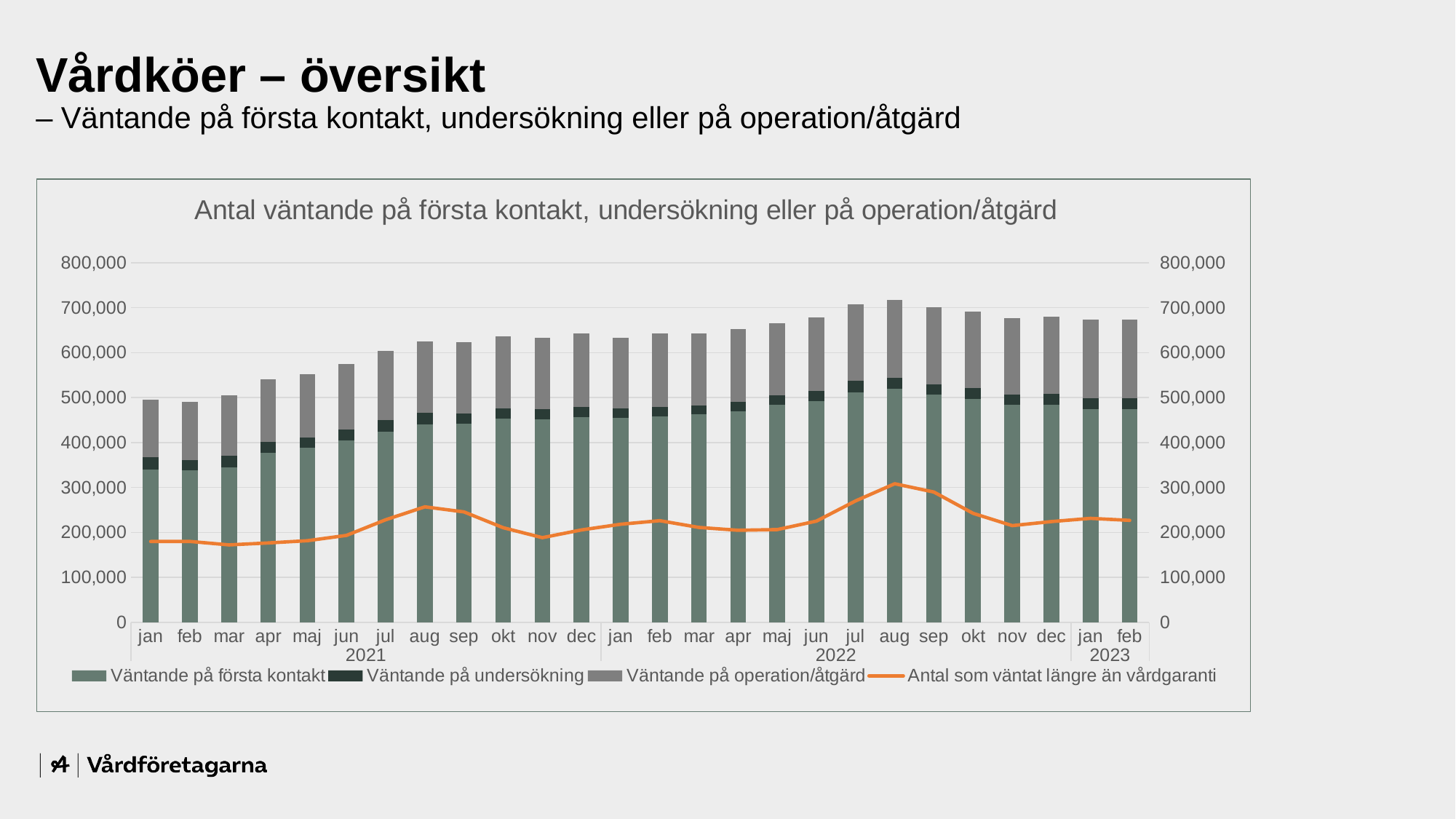
Do the total stacked bars generally rise or fall from jan 2021 to aug 2022? rise Is the value of the line 'Antal som väntat längre än vårdgaranti' for jan 2021 greater or less than 200,000? less Which has the larger total stacked bar, jan 2021 or aug 2022? aug 2022 In which month is the total stacked bar highest? aug 2022 Is the total stacked bar for aug 2021 greater or less than 600,000? greater What is the title of the chart? Antal väntande på första kontakt, undersökning eller på operation/åtgärd In which month does the line 'Antal som väntat längre än vårdgaranti' reach its highest point? aug 2022 How many monthly bars are plotted in the chart? 26 How many series does the legend list? 4 What kind of chart is shown on the slide? Stacked bar chart with a line Is the total stacked bar for aug 2022 greater or less than 700,000? greater